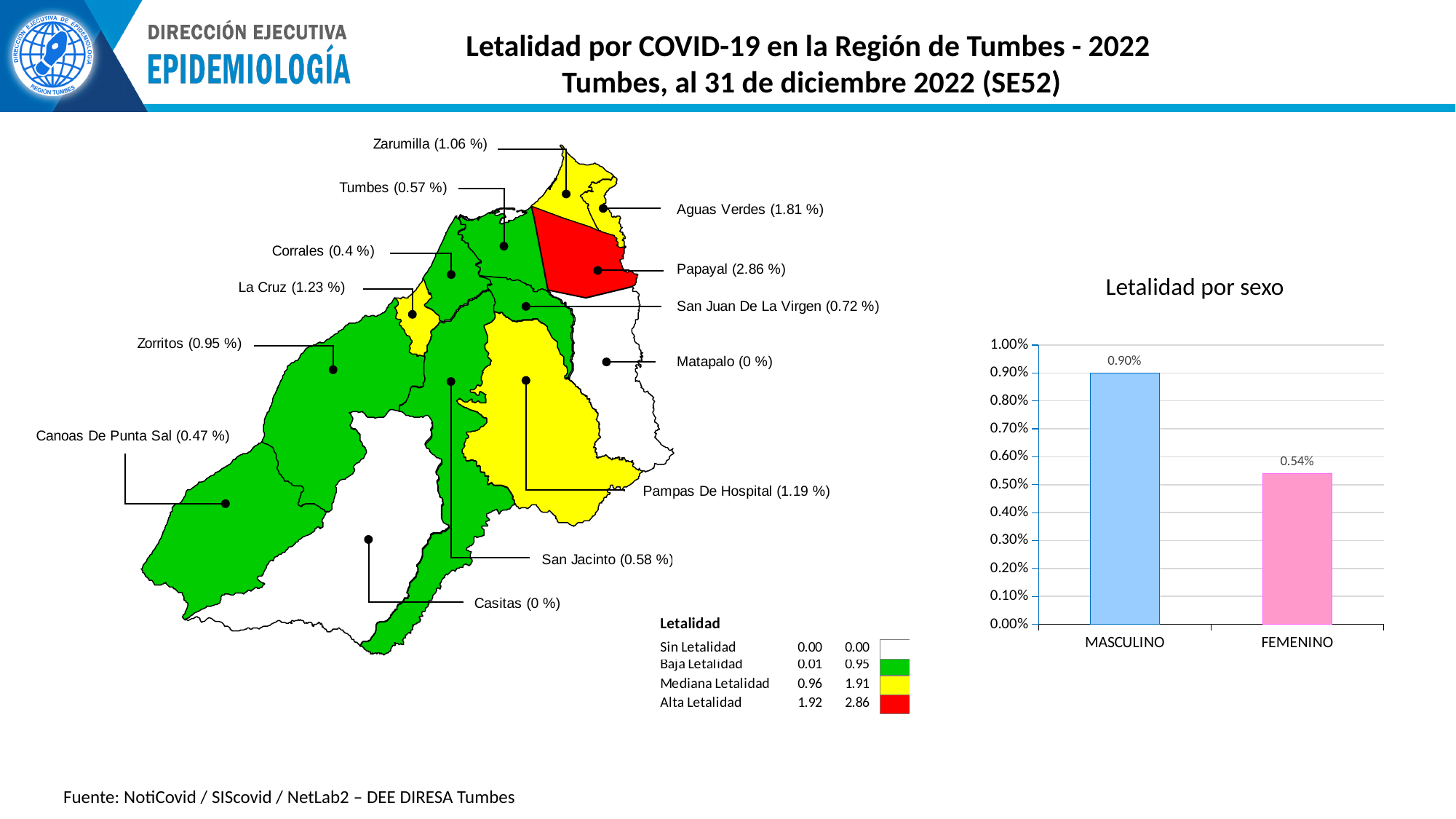
In the 'Letalidad por sexo' chart, what is the difference between the MASCULINO and FEMENINO values? 0.36% How many categories are shown in the 'Letalidad por sexo' chart? 2 In the 'Letalidad por sexo' chart, what is the value for FEMENINO? 0.54% In the 'Letalidad por sexo' chart, which category has the lowest value? FEMENINO In the 'Letalidad por sexo' chart, is the value for FEMENINO greater or less than 0.60%? less In the 'Letalidad por sexo' chart, what is the highest value shown on the vertical axis? 1.00% In the 'Letalidad por sexo' chart, is the value for MASCULINO greater or less than 0.80%? greater In the 'Letalidad por sexo' chart, what colour is the FEMENINO bar? pink What kind of chart is 'Letalidad por sexo'? bar chart In the 'Letalidad por sexo' chart, which category has the highest value? MASCULINO In the 'Letalidad por sexo' chart, what is the value for MASCULINO? 0.90% On the map, which district has the highest lethality value? Papayal (2.86 %)